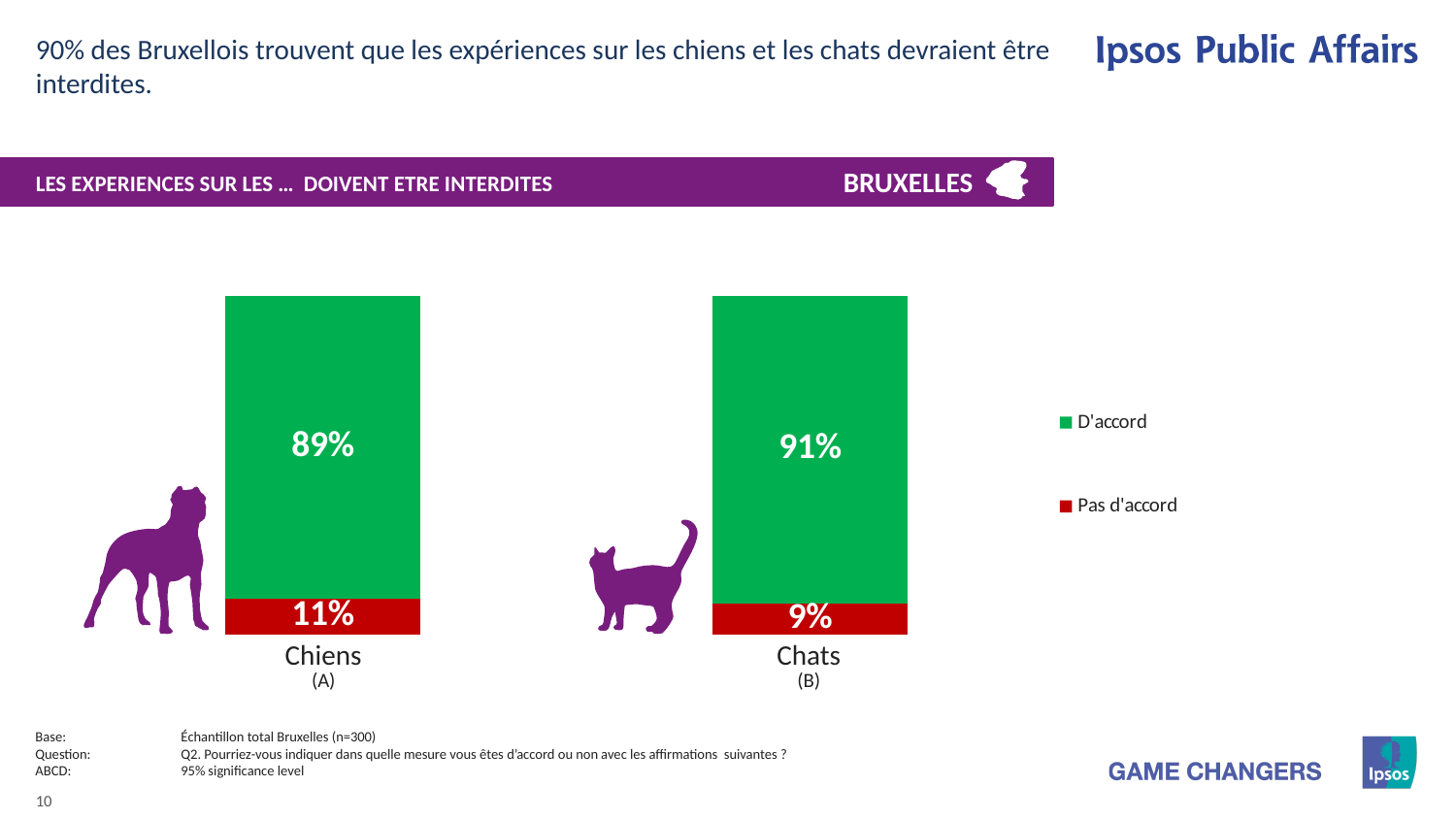
What kind of chart is shown on the slide? Stacked bar chart What percentage of Bruxellois agree (D'accord) that experiments on cats (Chats) should be banned? 91% What is the total of the stacked bar for Chiens? 100% What is the 'Pas d'accord' value for Chiens? 11% Which category has the higher 'D'accord' share, Chiens or Chats? Chats Which colour represents 'Pas d'accord' in the chart? Red How many series does the legend list? 2 Which category has the lower 'Pas d'accord' share? Chats How many categories are shown on the x axis? 2 What is the 'Pas d'accord' value for Chats? 9% What is the difference between the 'D'accord' values for Chats and Chiens? 2% What percentage of Bruxellois agree (D'accord) that experiments on dogs (Chiens) should be banned? 89%